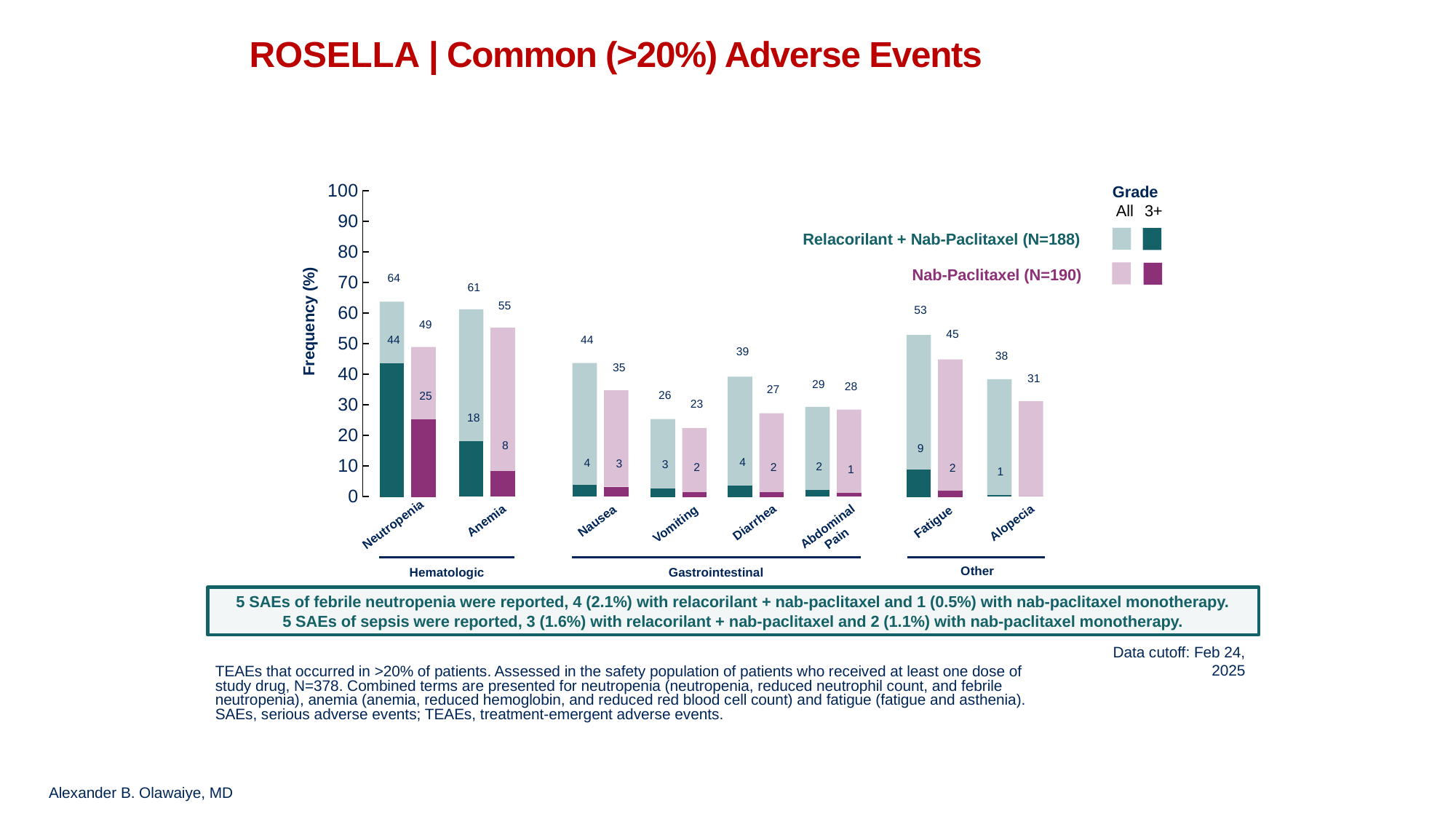
Which adverse event has the highest all-grade frequency in the Relacorilant + Nab-Paclitaxel arm? Neutropenia What is the difference in all-grade diarrhea frequency between the Relacorilant + Nab-Paclitaxel arm (39) and the Nab-Paclitaxel arm (27)? 12 Which arm has the higher all-grade frequency of nausea? Relacorilant + Nab-Paclitaxel What is the all-grade frequency of neutropenia in the Relacorilant + Nab-Paclitaxel arm? 64 What type of chart is shown on the slide? Bar chart How many adverse event categories are shown on the x axis? 8 What is the label of the y axis? Frequency (%) Is the all-grade frequency of alopecia in the Relacorilant + Nab-Paclitaxel arm greater or less than 30? greater Which adverse event has the lowest all-grade frequency in the Nab-Paclitaxel arm? Vomiting How many treatment arms does the legend list? 2 What is the all-grade frequency of fatigue in the Nab-Paclitaxel arm? 45 What is the grade 3+ frequency of anemia in the Nab-Paclitaxel arm? 8